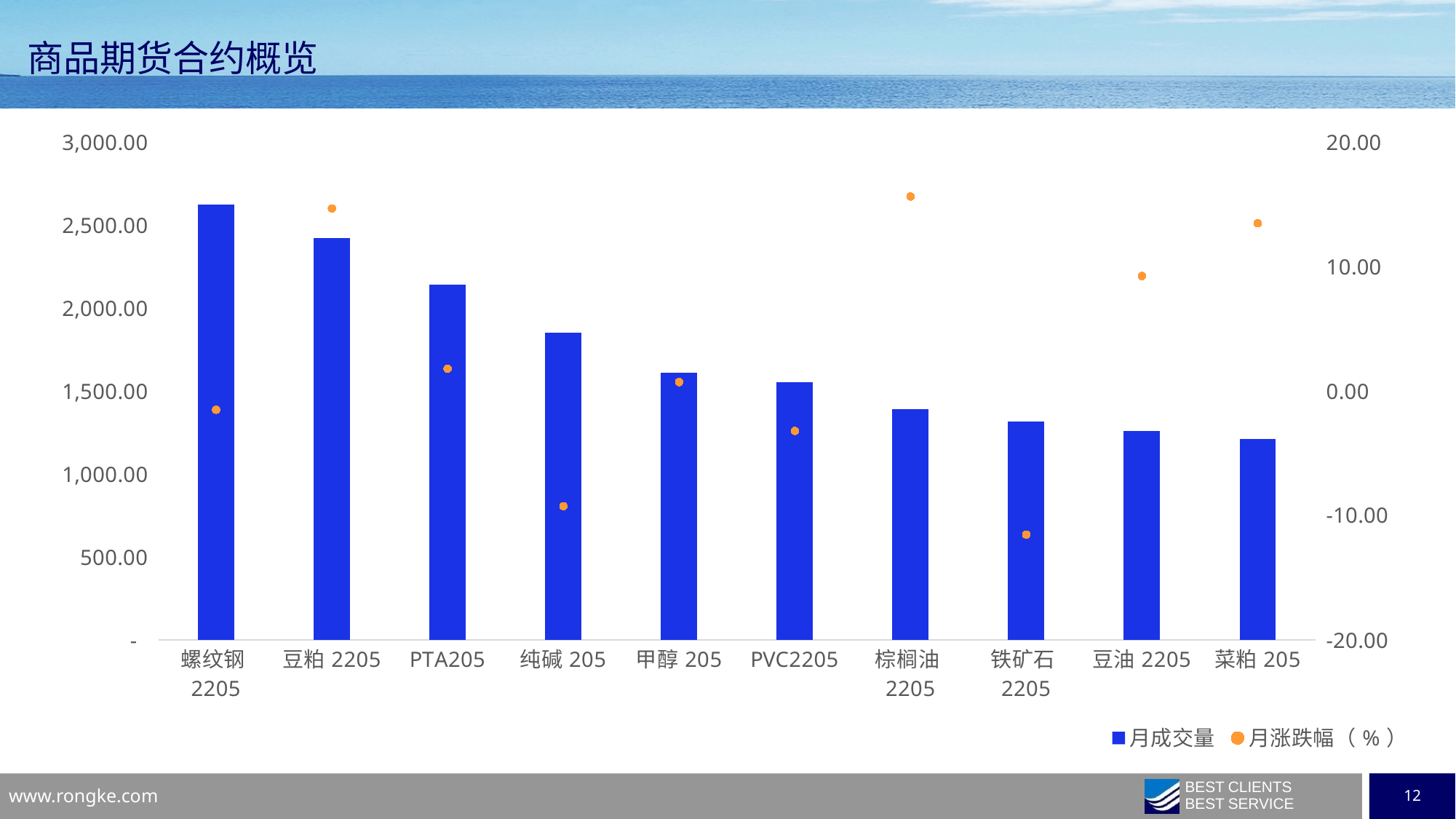
Is the 月涨跌幅 (%) value for 豆粕 2205 greater or less than 10.00? greater Do the 月成交量 bars rise or fall from left to right along the x axis? fall How many contract categories are shown on the x axis? 10 Is the 月涨跌幅 (%) value for 铁矿石 2205 greater or less than -10.00? less How many series does the legend list? 2 Which contract has the lowest 月涨跌幅 (%) dot? 铁矿石 2205 Is the 月成交量 value for 菜粕 205 greater or less than 1,500.00? less Which contract has the lowest 月成交量 bar? 菜粕 205 Which has the larger 月成交量 bar, 豆粕 2205 or PTA205? 豆粕 2205 What kind of chart is shown on the slide? A combined bar and scatter (dot) chart Which contract has the highest 月成交量 bar? 螺纹钢 2205